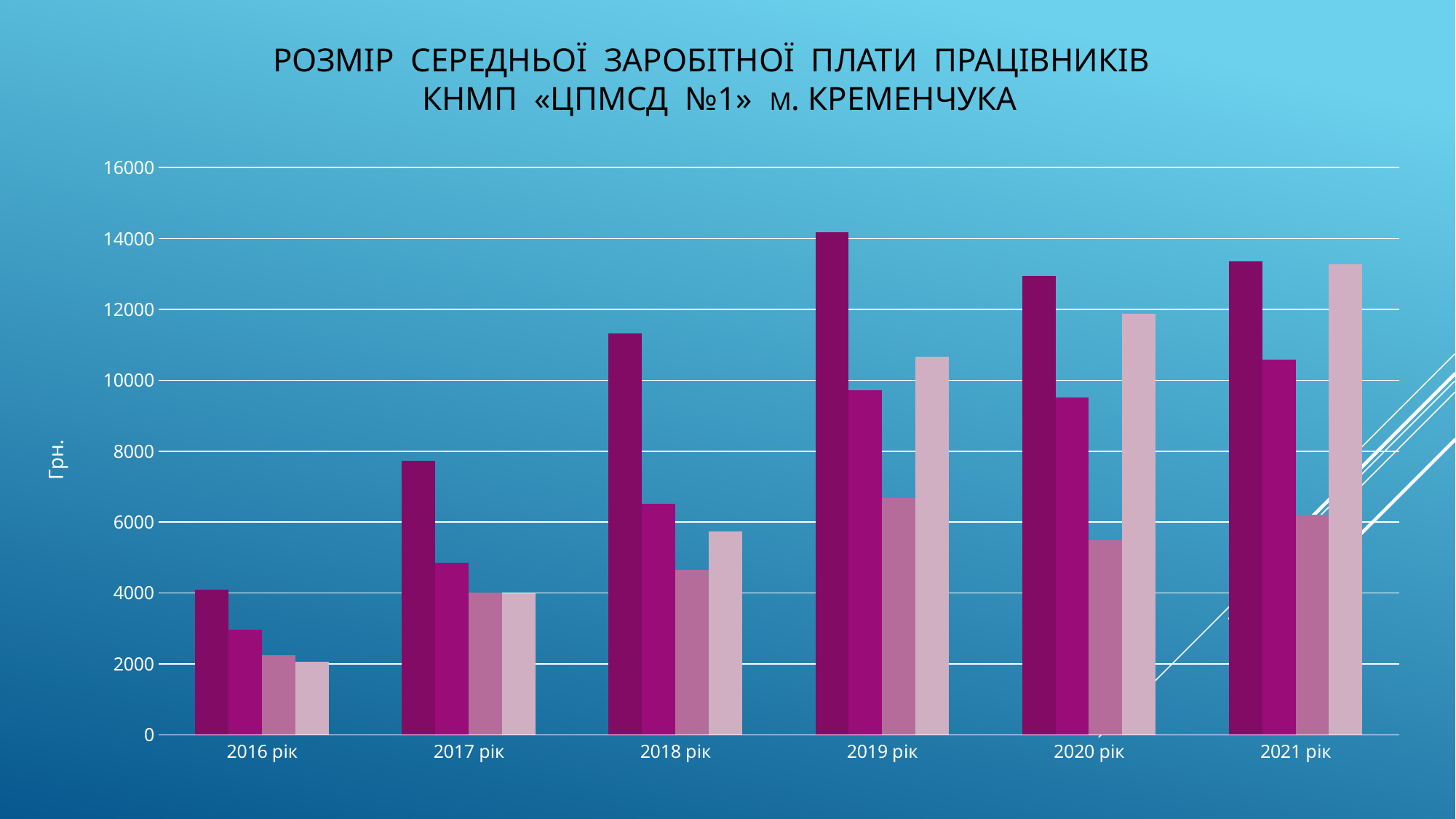
Which year has the tallest dark purple (first) bar? 2019 рік Which is larger: the dark purple (first) bar for 2019 рік or the dark purple (first) bar for 2020 рік? 2019 рік What kind of chart is shown on the slide? bar chart Which year has the shortest dark purple (first) bar? 2016 рік Is the lightest pink (fourth) bar for 2021 рік greater or less than 12000? greater Is the dark purple (first) bar for 2017 рік greater or less than 8000? less How many bars are plotted for each year in the chart? 4 What label is shown on the vertical axis of the chart? Грн. How many years are shown along the x axis of the chart? 6 Is the dark purple (first) bar for 2018 рік greater or less than 10000? greater Which is larger for 2021 рік: the second (magenta) bar or the fourth (lightest pink) bar? the fourth (lightest pink) bar